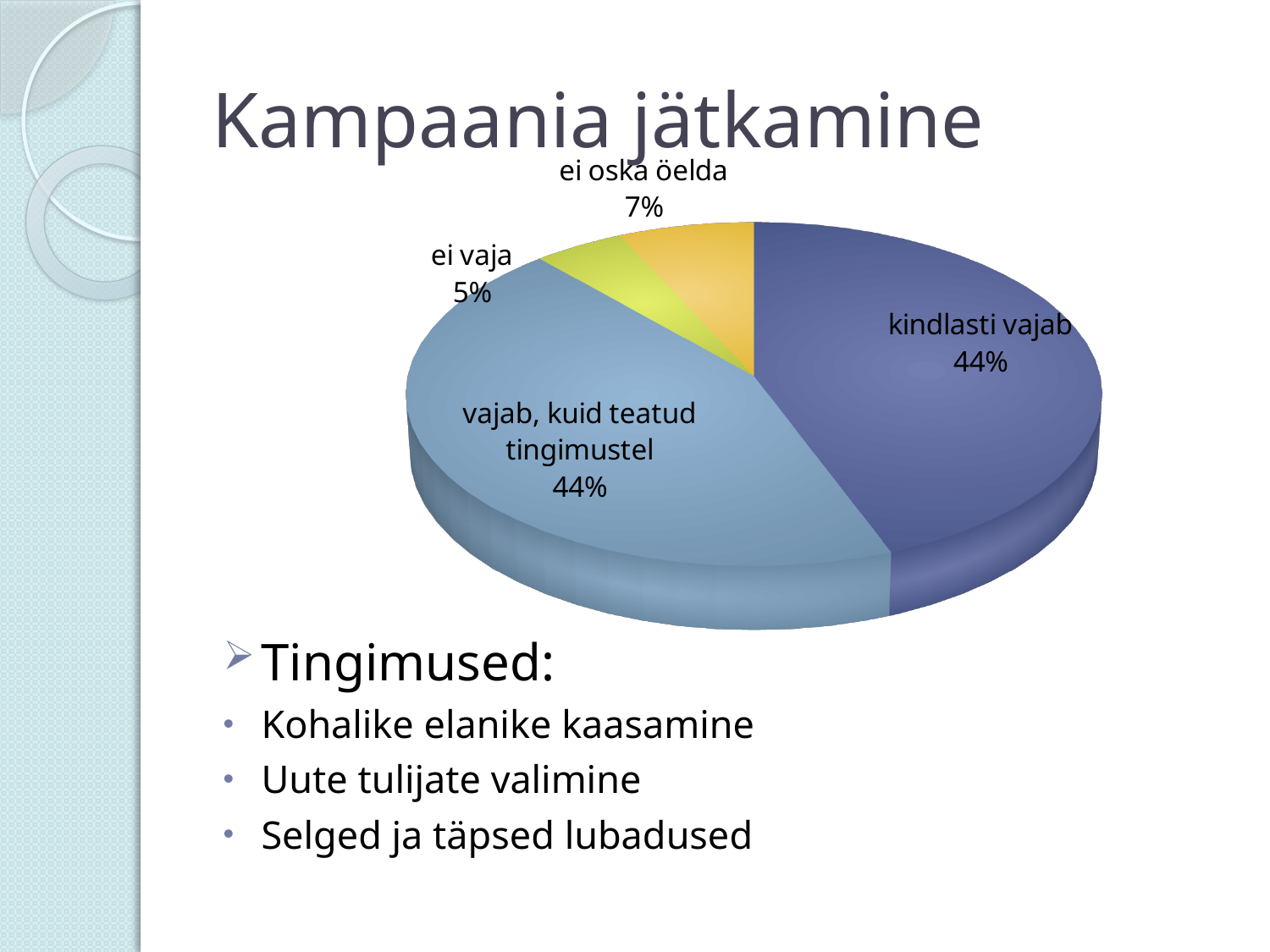
What is the value shown for "ei vaja"? 5% Which is larger, "ei oska öelda" or "ei vaja"? ei oska öelda What kind of chart is shown on the slide? pie chart Which slice of the pie chart is the smallest? ei vaja What share of the pie does "vajab, kuid teatud tingimustel" have? 44% Do "kindlasti vajab" and "vajab, kuid teatud tingimustel" have the same share of the pie? yes What colour is the "ei oska öelda" slice? yellow How many slices does the pie chart have? 4 What is the difference in percentage points between "ei oska öelda" and "ei vaja"? 2 What is the value shown for "ei oska öelda"? 7% What share of the pie does "kindlasti vajab" have? 44% What is the difference in percentage points between "kindlasti vajab" and "ei oska öelda"? 37